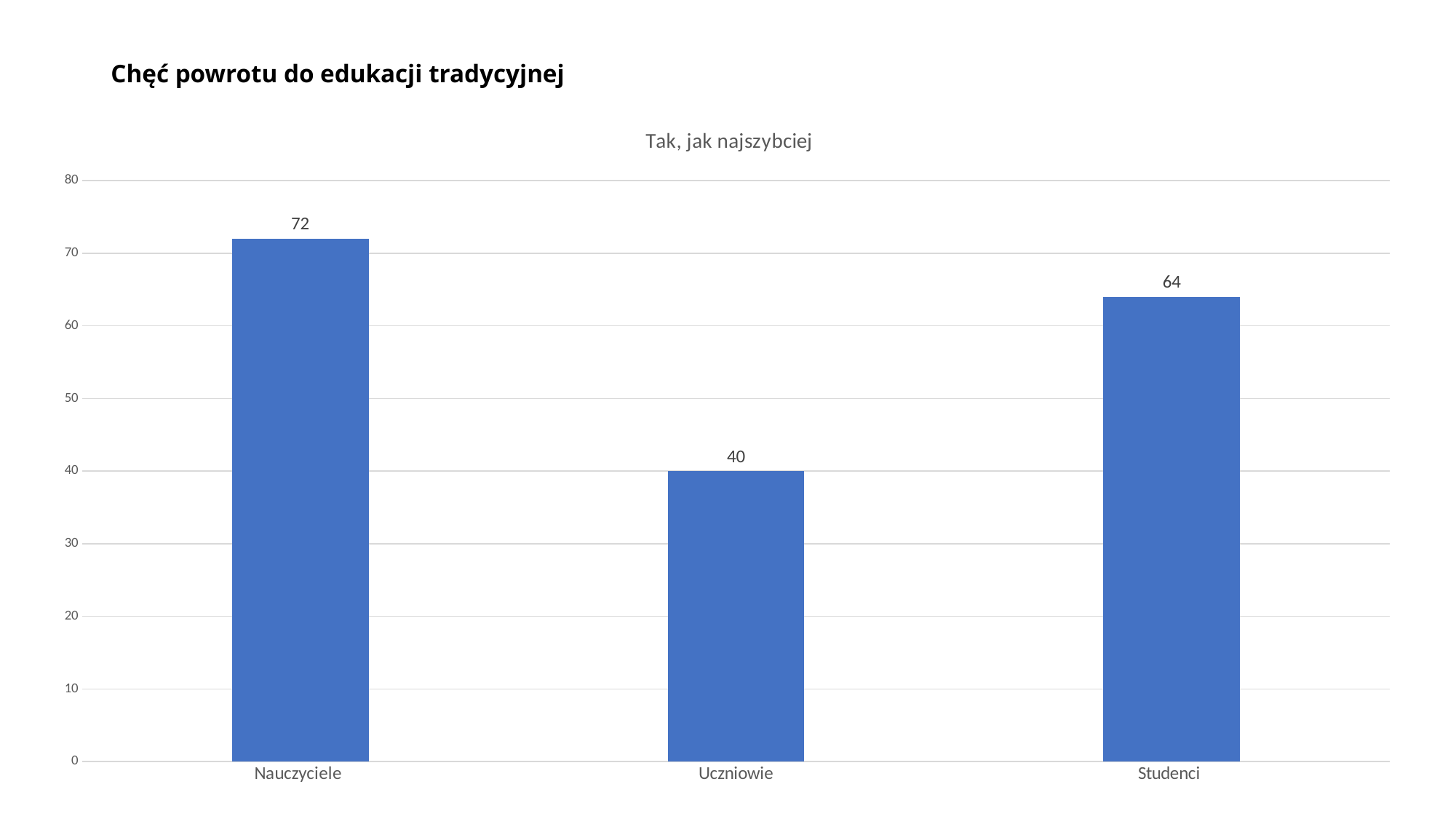
Which category has the lowest value? Uczniowie What is the difference between the values for Studenci and Uczniowie? 24 Which category has the highest value? Nauczyciele What is the title of the chart? Tak, jak najszybciej Is the value for Studenci greater or less than 60? greater What is the value for Uczniowie? 40 What is the difference between the values for Nauczyciele and Studenci? 8 What is the value for Nauczyciele? 72 What is the value for Studenci? 64 What kind of chart is shown on the slide? bar chart Which is larger, the value for Uczniowie or the value for Studenci? Studenci How many categories are shown on the chart? 3